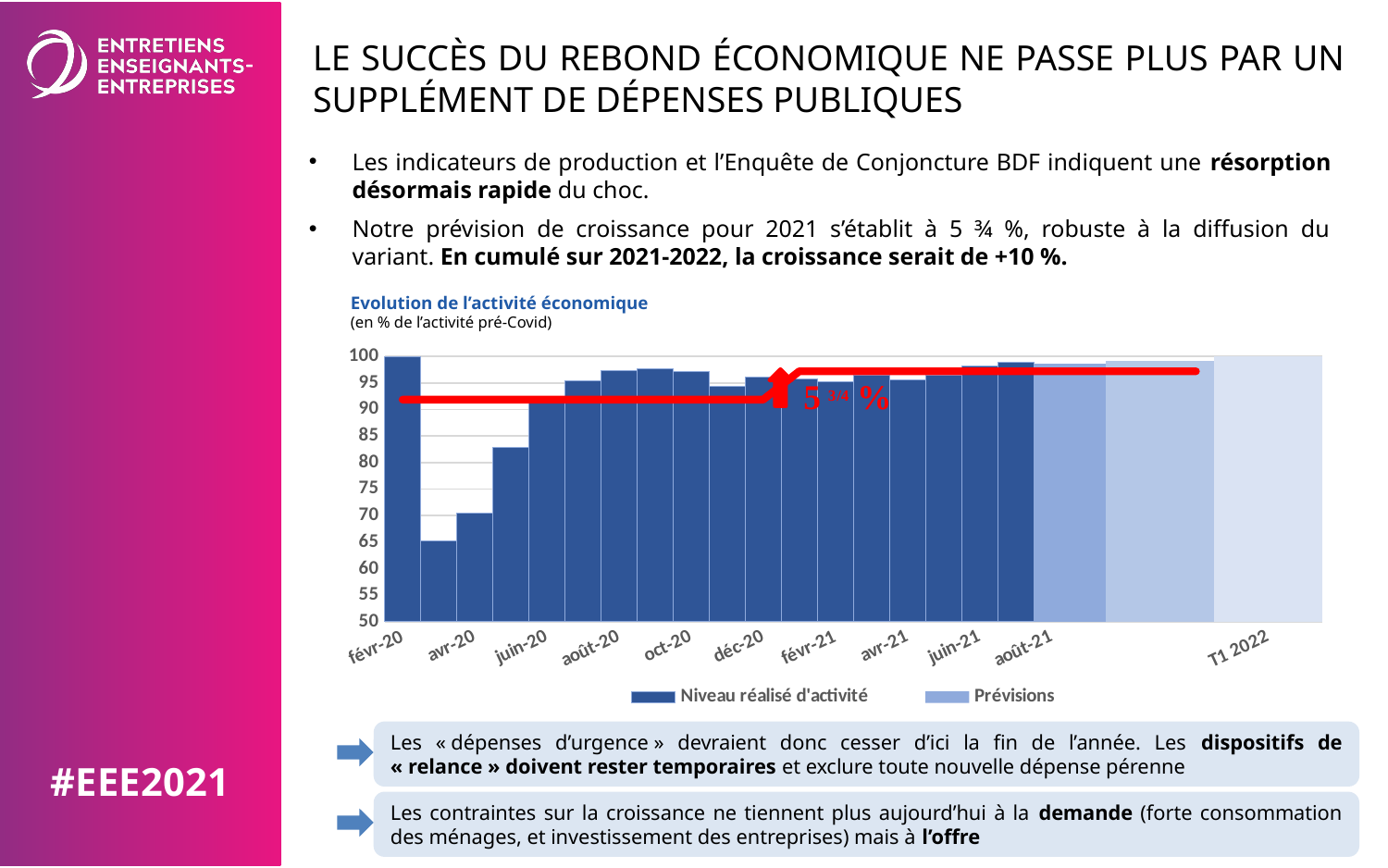
How many series does the chart legend list? 2 Which is larger, the value for août-20 or the value for avr-20? août-20 Which is larger, the value for févr-20 or the value for avr-20? févr-20 What is the title of the chart? Evolution de l'activité économique What kind of chart is shown on the slide? bar chart Is the value for avr-20 greater or less than 75? less Do the values rise or fall from avr-20 to août-20? rise Is the value for août-20 greater or less than 90? greater How many labels are shown on the x axis of the chart? 11 Is the value for févr-20 greater or less than 95? greater What are the two series named in the chart legend? Niveau réalisé d'activité and Prévisions